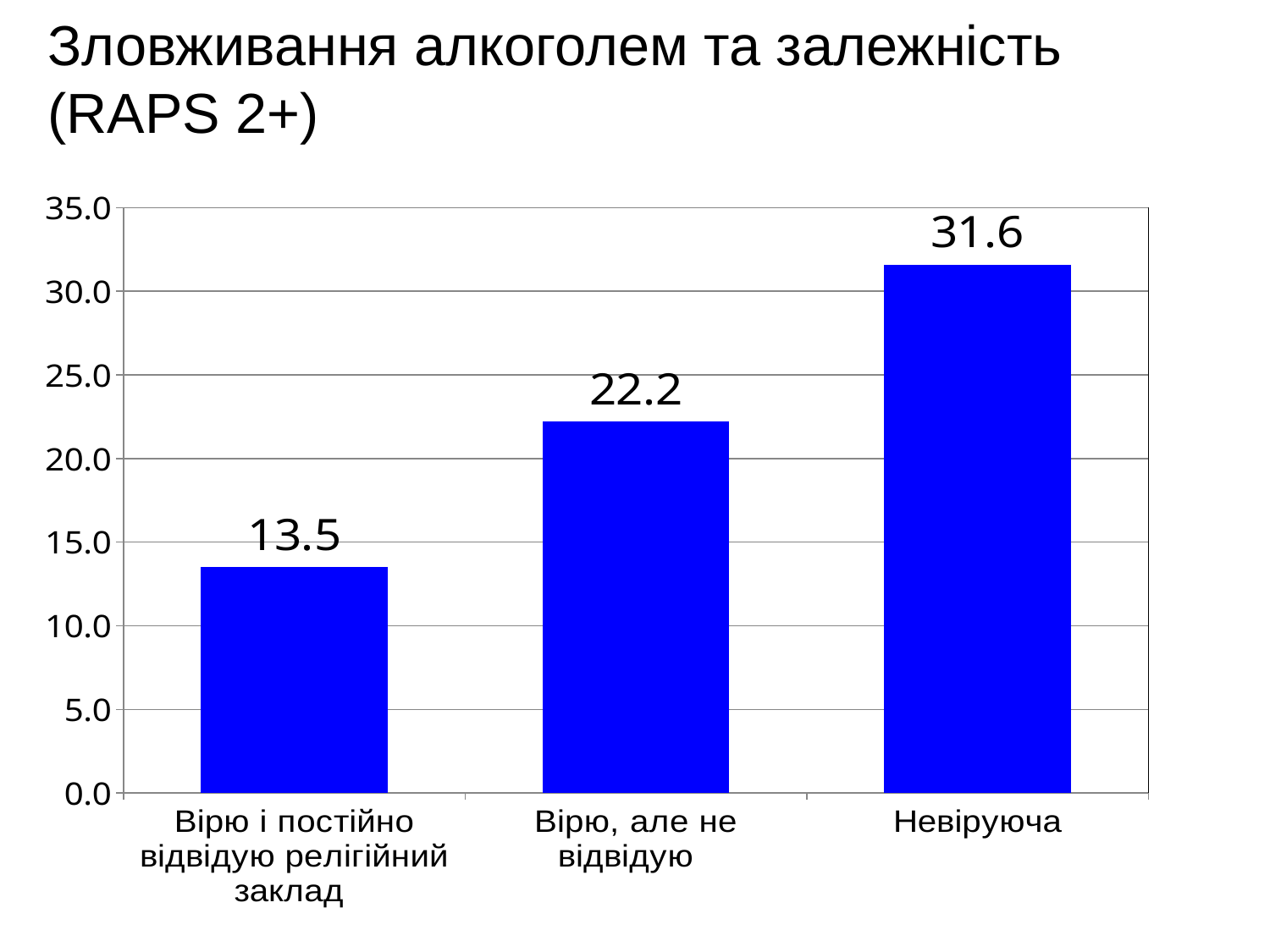
Which category has the highest value? Невіруюча What is the value for "Вірю, але не відвідую"? 22.2 What kind of chart is shown on the slide? bar chart What is the difference between the values for "Вірю, але не відвідую" and "Вірю і постійно відвідую релігійний заклад"? 8.7 Do the values rise or fall from left to right along the x axis? rise How many categories are shown on the chart? 3 What is the value for "Вірю і постійно відвідую релігійний заклад"? 13.5 Is the value for "Невіруюча" greater or less than 30.0? greater What is the difference between the values for "Невіруюча" and "Вірю, але не відвідую"? 9.4 Which category has the lowest value? Вірю і постійно відвідую релігійний заклад Which is larger: the value for "Вірю, але не відвідую" or for "Вірю і постійно відвідую релігійний заклад"? Вірю, але не відвідую What is the value for "Невіруюча"? 31.6